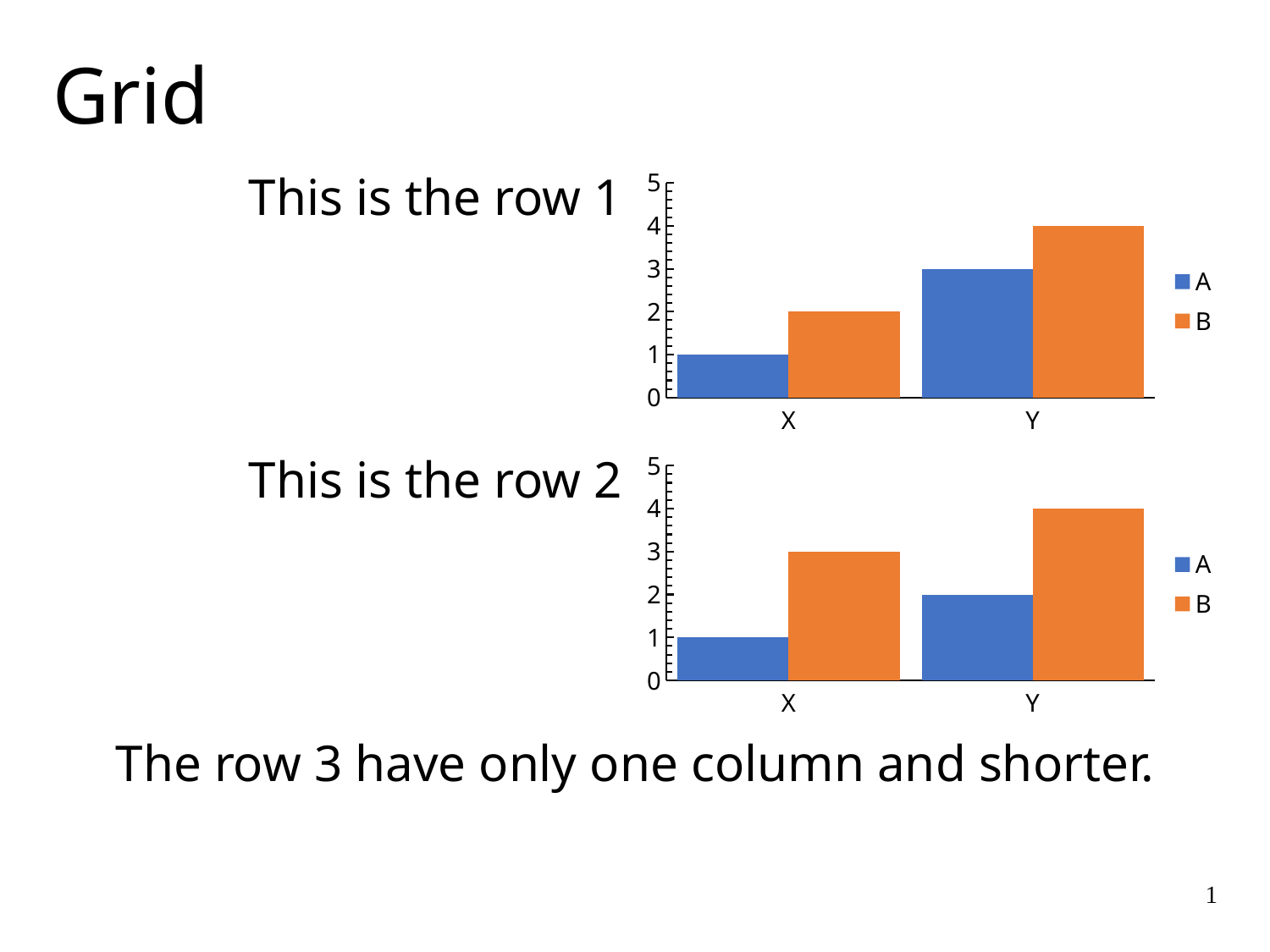
How many series does the legend of the bottom chart list? 2 In the top chart, which category has the highest value for series A? Y In the top chart, what is the value of series B for category Y? 4 In the bottom chart, which category has the lowest value for series A? X In the bottom chart, what is the difference between series B and series A for category X? 2 How many categories are shown on the x axis of the top chart? 2 In the bottom chart, which is larger for category Y: series A or series B? B What kind of chart is the top chart? Bar chart In the bottom chart, what is the value of series B for category X? 3 In the top chart, what is the value of series A for category X? 1 In the top chart, what is the difference between series B and series A for category Y? 1 In the bottom chart, what is the value of series A for category Y? 2